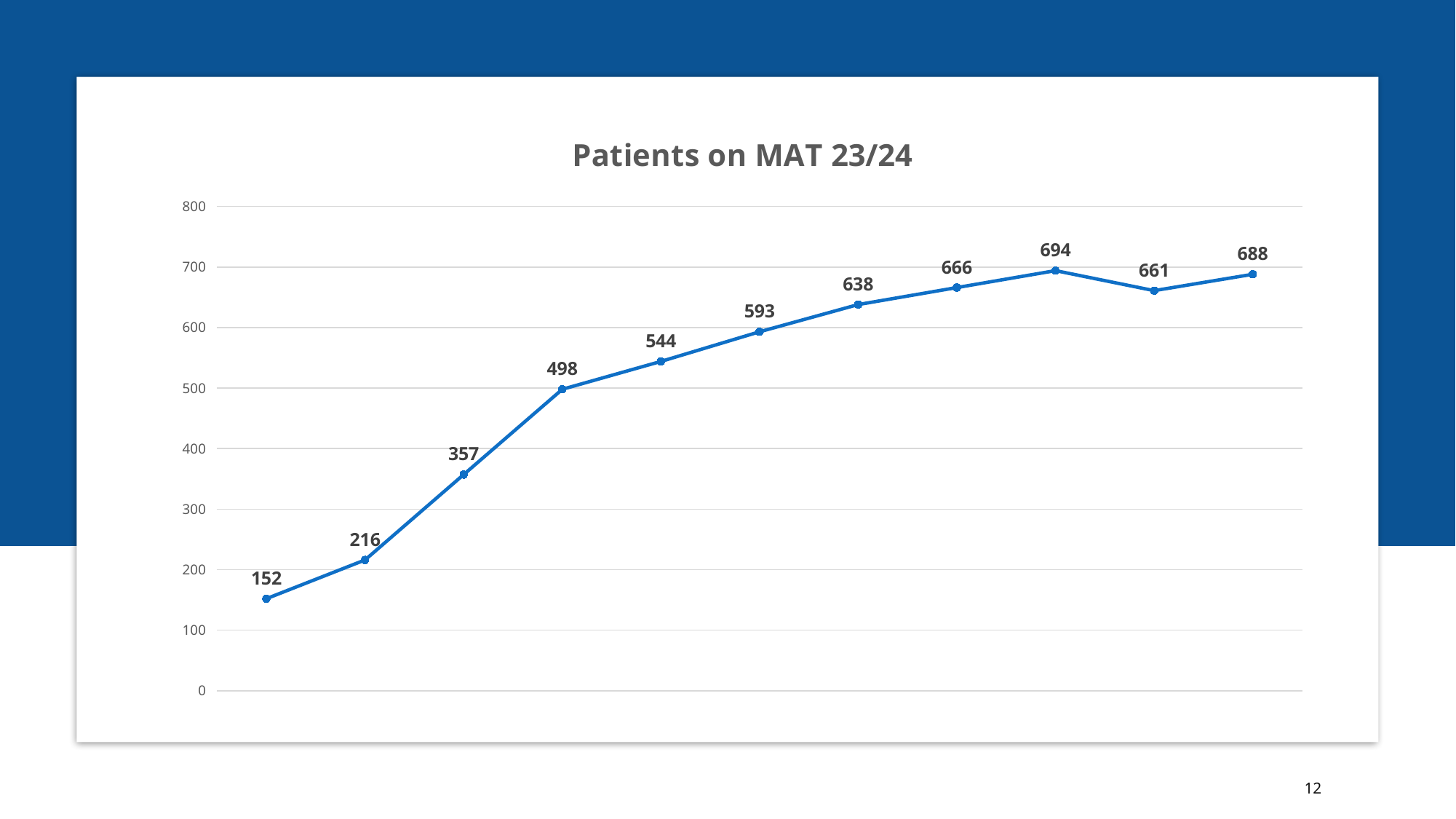
What is the maximum value shown on the vertical axis? 800 What is the difference between the last data point (688) and the first data point (152)? 536 What is the title of the chart? Patients on MAT 23/24 How many data points are plotted on the line? 11 What kind of chart is shown on the slide? line chart What is the highest value plotted on the chart? 694 What is the value of the first data point on the line? 152 What is the value of the last data point on the line? 688 What is the lowest value plotted on the chart? 152 Do the values generally rise or fall from left to right along the x axis? rise What is the difference between the highest value (694) and the value immediately after it (661)? 33 Which is larger, the fourth data point (498) or the fifth data point (544)? 544